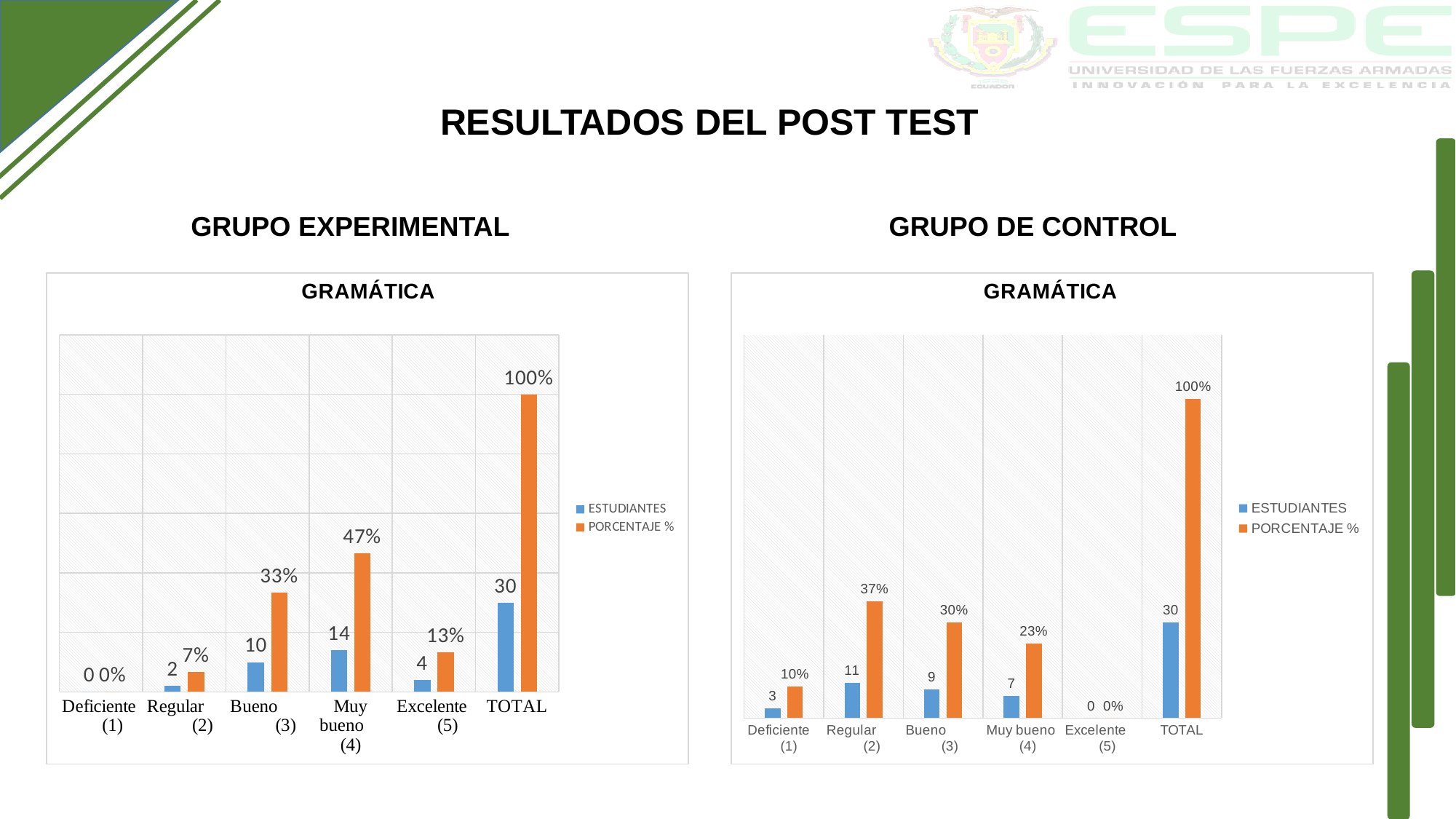
What is the title shown inside the GRUPO DE CONTROL chart? GRAMÁTICA How many categories are shown on the x axis of the GRUPO DE CONTROL chart? 6 In the GRUPO DE CONTROL chart, which has more ESTUDIANTES: Regular (2) or Bueno (3)? Regular (2) What type of chart is the GRUPO EXPERIMENTAL chart? Bar chart In the GRUPO DE CONTROL chart, what is the PORCENTAJE % for Muy bueno (4)? 23% In the GRUPO DE CONTROL chart, how many ESTUDIANTES are in the Regular (2) category? 11 In the GRUPO EXPERIMENTAL chart, excluding TOTAL, which category has the highest number of ESTUDIANTES? Muy bueno (4) In the GRUPO DE CONTROL chart, excluding TOTAL, which category has the lowest number of ESTUDIANTES? Excelente (5) In the GRUPO EXPERIMENTAL chart, what is the difference in ESTUDIANTES between Muy bueno (4) and Bueno (3)? 4 In the GRUPO EXPERIMENTAL chart, how many ESTUDIANTES are in the Muy bueno (4) category? 14 How many series does the legend of the GRUPO EXPERIMENTAL chart list? 2 In the GRUPO EXPERIMENTAL chart, what is the PORCENTAJE % for Bueno (3)? 33%